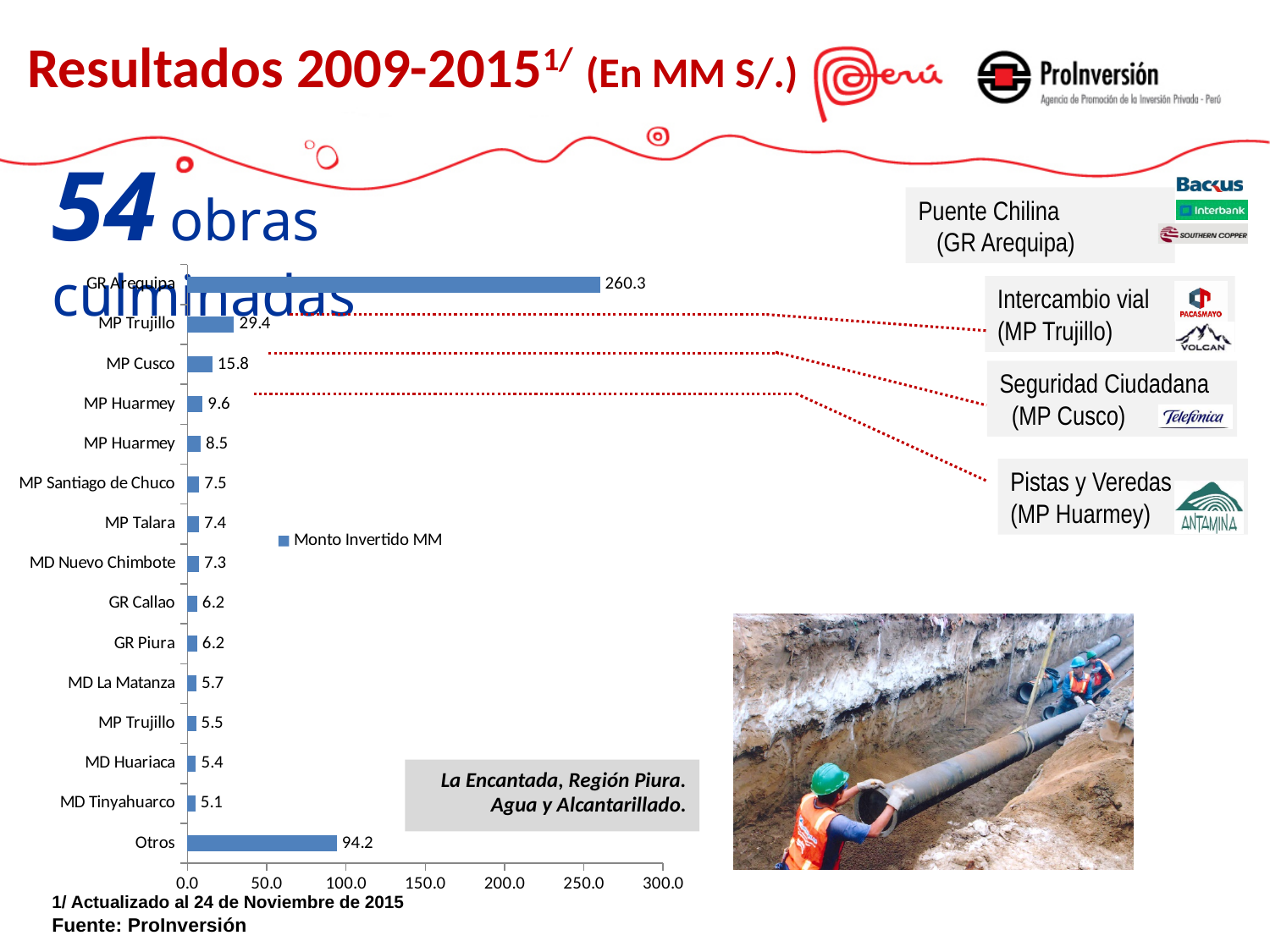
What is the value for MD Tinyahuarco? 5.1 What type of chart is shown on the slide? bar chart What is the value for MP Cusco? 15.8 What is the value for Otros? 94.2 Which category has the lowest value? MD Tinyahuarco What series name does the legend show? Monto Invertido MM What is the difference between the values for GR Arequipa and Otros? 166.1 What is the value for GR Arequipa? 260.3 Which is larger, the value for MP Cusco or the value for MD Nuevo Chimbote? MP Cusco What is the value for MP Santiago de Chuco? 7.5 How many categories are shown on the chart? 15 Which category has the highest value? GR Arequipa